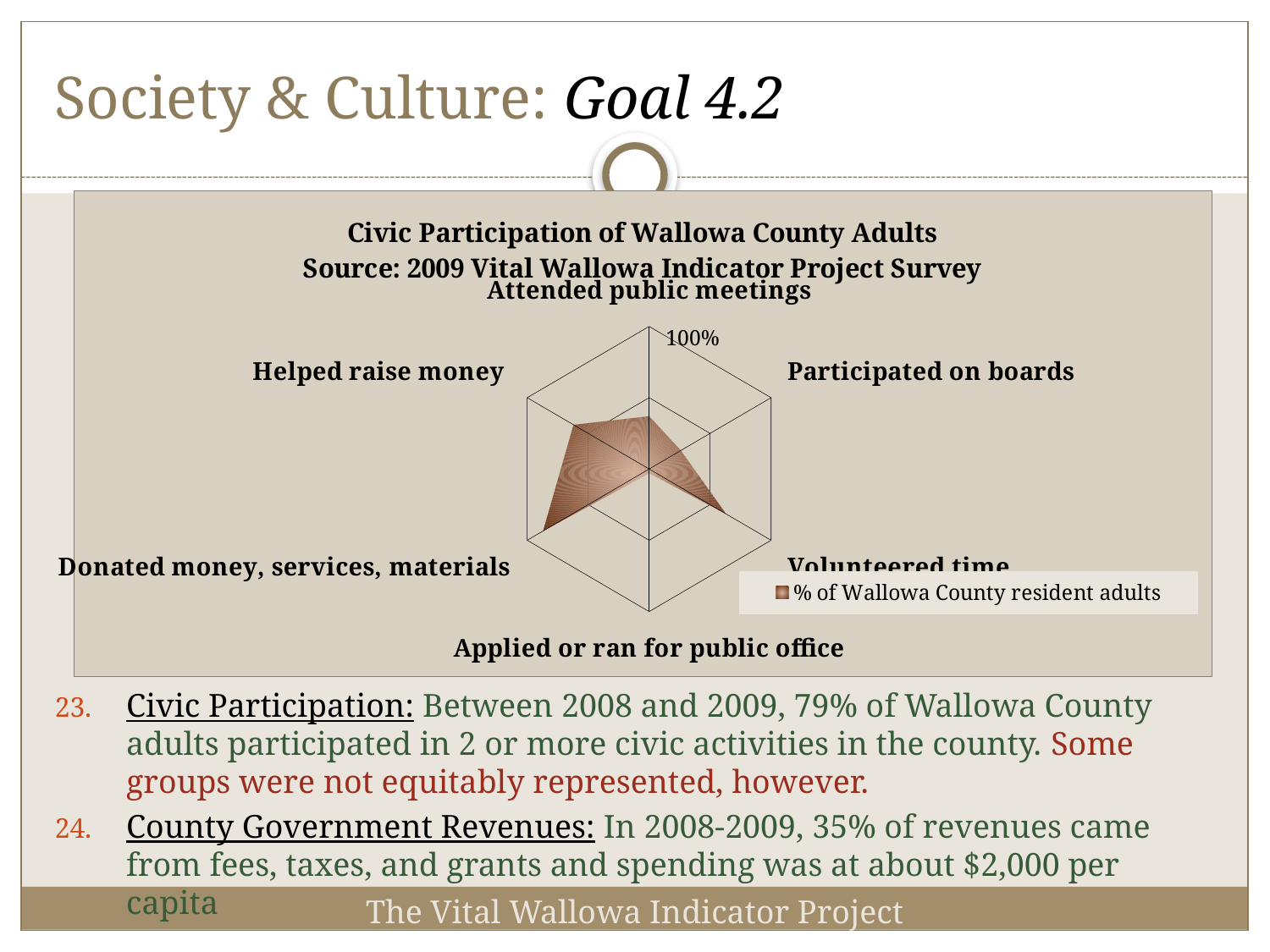
Which is larger: the value for Helped raise money or the value for Attended public meetings? Helped raise money What is the title of the chart? Civic Participation of Wallowa County Adults How many civic activity categories are plotted on the radar chart? 6 What kind of chart is shown on the slide? Radar chart Which is larger: the value for Volunteered time or the value for Participated on boards? Volunteered time What is the only percentage tick label shown on the chart's axis? 100% Which civic activity has the lowest value on the chart? Applied or ran for public office Is the value for Applied or ran for public office greater or less than 100%? less Which is larger: the value for Donated money, services, materials or the value for Applied or ran for public office? Donated money, services, materials How many series does the chart's legend list? 1 What is the series name shown in the chart's legend? % of Wallowa County resident adults